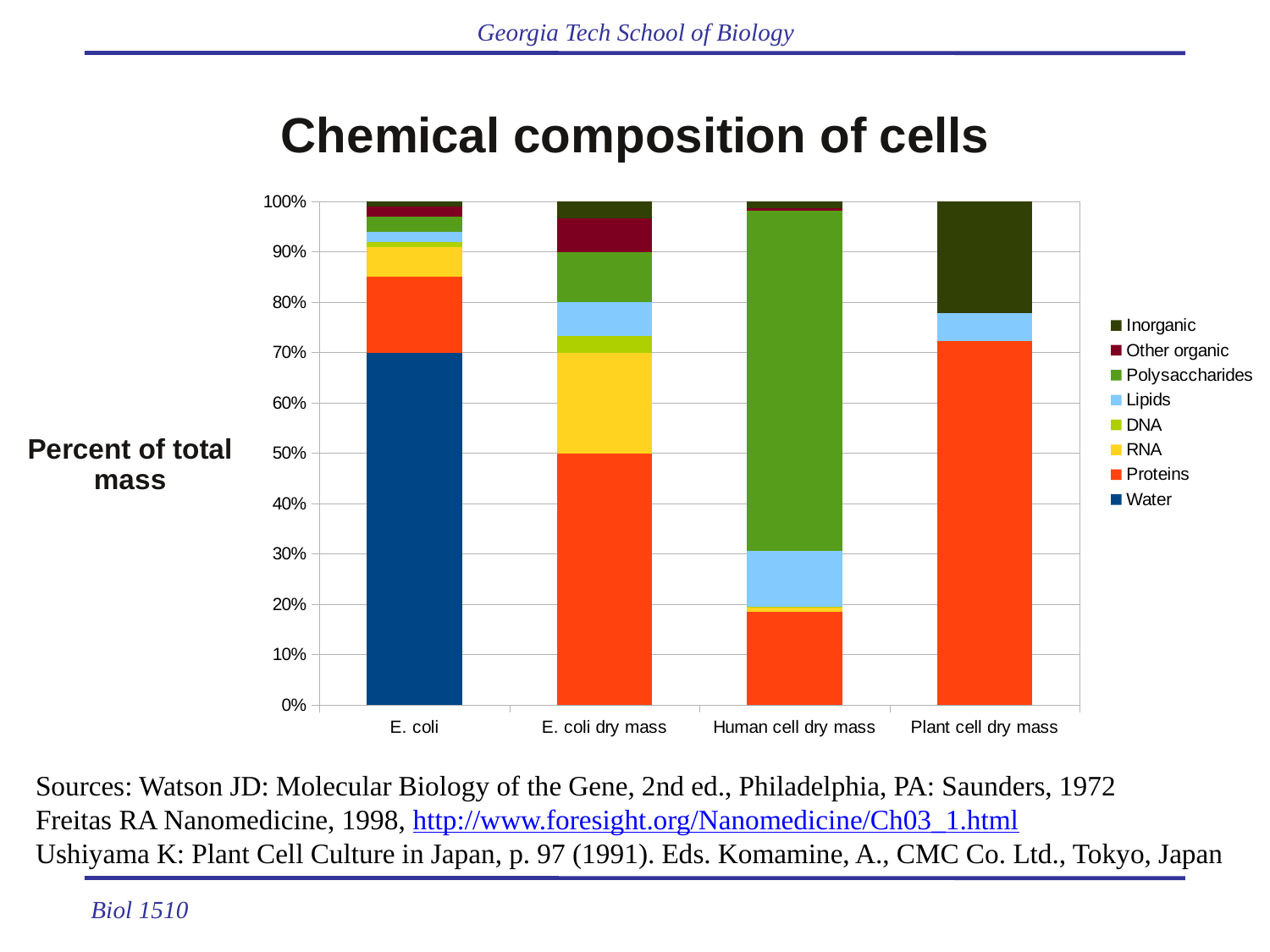
What percentage of total mass is Water in the E. coli bar? 70% Is the Polysaccharides value for Human cell dry mass greater or less than 50%? greater Which is larger: the Water segment for E. coli or the Proteins segment for E. coli dry mass? Water segment for E. coli What is the label on the vertical axis of the chart? Percent of total mass What is the title of the chart? Chemical composition of cells How many series does the chart's legend list? 8 How many categories are shown on the x axis of the chart? 4 Which category has the largest Polysaccharides segment? Human cell dry mass What percentage of total mass is Proteins in the E. coli dry mass bar? 50% Is the Inorganic value for Plant cell dry mass greater or less than 30%? less What kind of chart is shown on the slide? Stacked bar chart Is the Proteins value for Plant cell dry mass greater or less than 70%? greater